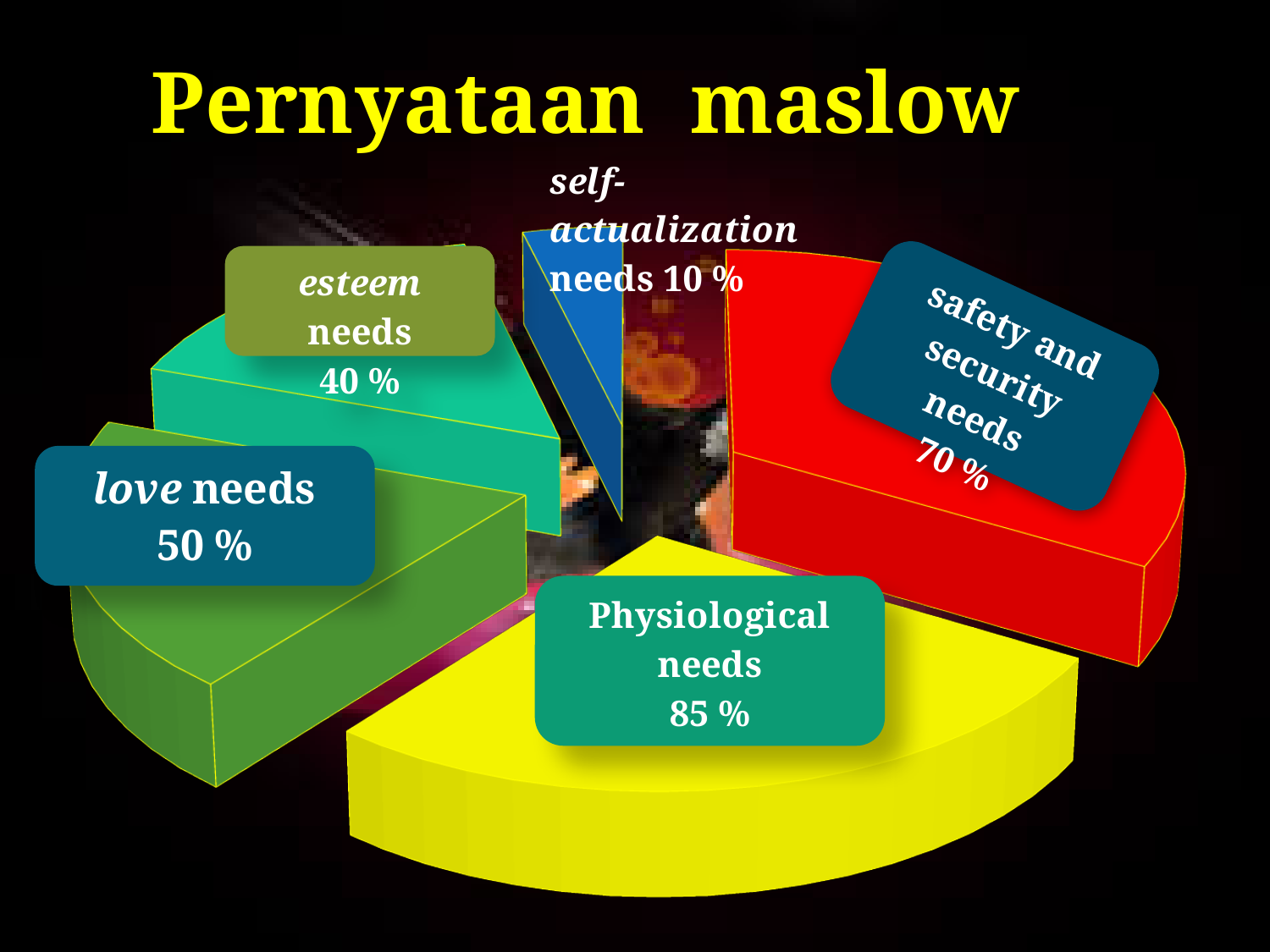
What value is labelled for safety and security needs? 70 % What value is labelled for esteem needs? 40 % What is the difference between the labelled values for Physiological needs and safety and security needs? 15 % What is the title of the slide containing the pie chart? Pernyataan maslow Which category has the lowest labelled value? self-actualization needs How many slices does the pie chart have? 5 What kind of chart is shown on the slide? pie chart What value is labelled for self-actualization needs? 10 % What value is labelled for love needs? 50 % Which category has the highest labelled value? Physiological needs What value is labelled for Physiological needs? 85 % Which has the larger labelled value, love needs or esteem needs? love needs